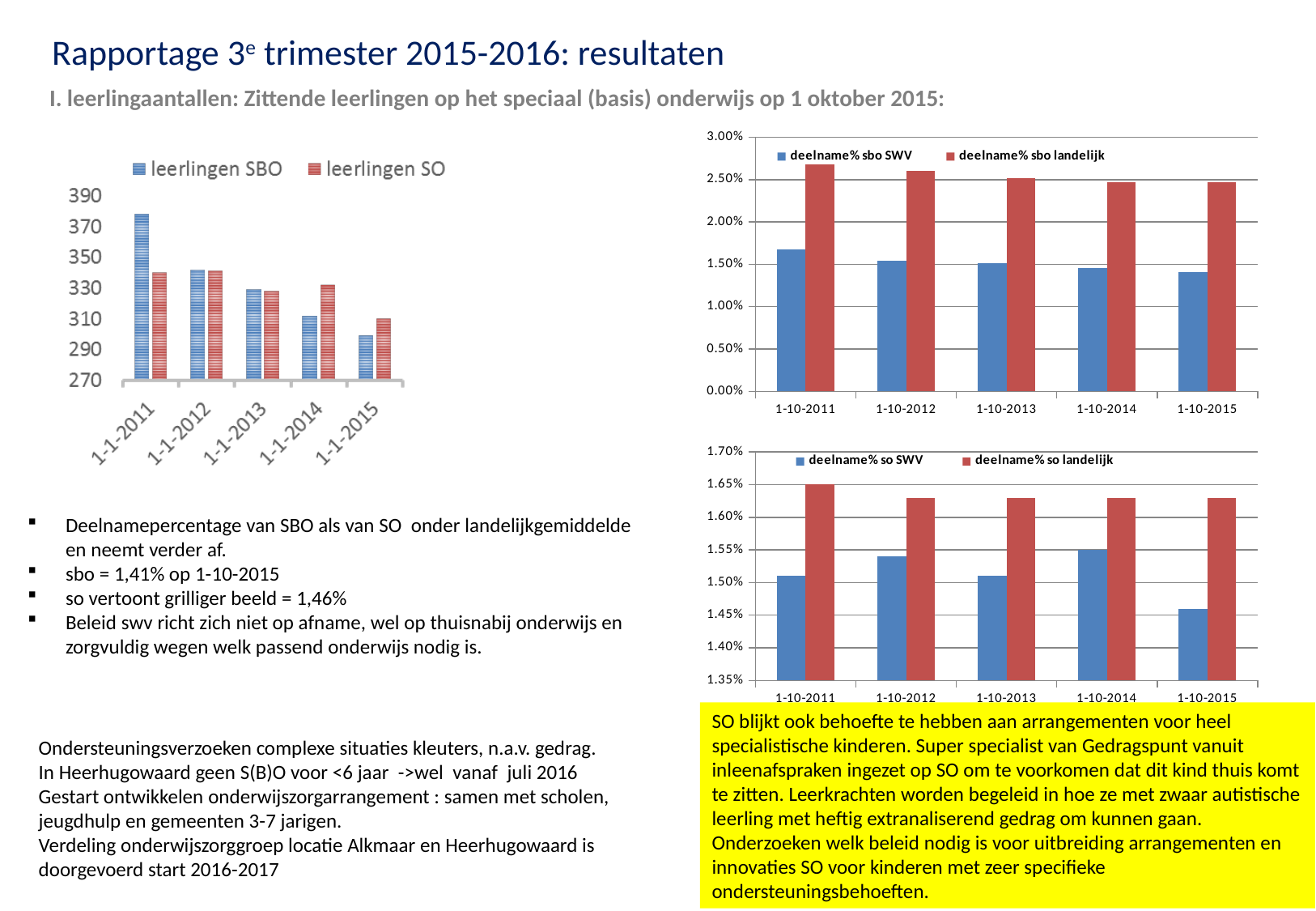
In the chart at the top left (leerlingen SBO / leerlingen SO), is the value for leerlingen SBO on 1-1-2011 greater or less than 370? greater In the top right chart (deelname% sbo SWV / deelname% sbo landelijk), which is larger on 1-10-2011: deelname% sbo SWV or deelname% sbo landelijk? deelname% sbo landelijk In the chart at the top left (leerlingen SBO / leerlingen SO), how many dates are shown on the x axis? 5 In the chart at the top left (leerlingen SBO / leerlingen SO), do the values for leerlingen SBO rise or fall from 1-1-2011 to 1-1-2015? fall In the top right chart (deelname% sbo SWV / deelname% sbo landelijk), is the value for deelname% sbo SWV on 1-10-2015 greater or less than 1.50%? less In the bottom right chart (deelname% so SWV / deelname% so landelijk), on which date is the value for deelname% so SWV lowest? 1-10-2015 In the chart at the top left (leerlingen SBO / leerlingen SO), which is larger on 1-1-2011: leerlingen SBO or leerlingen SO? leerlingen SBO In the chart at the top left (leerlingen SBO / leerlingen SO), on which date is the value for leerlingen SBO highest? 1-1-2011 In the chart at the top left with legend 'leerlingen SBO' and 'leerlingen SO', how many series does the legend list? 2 What kind of chart is the top right chart with legend 'deelname% sbo SWV' and 'deelname% sbo landelijk'? bar chart In the bottom right chart (deelname% so SWV / deelname% so landelijk), is the value for deelname% so landelijk on 1-10-2011 greater or less than 1.60%? greater In the chart at the top left (leerlingen SBO / leerlingen SO), on which date is the value for leerlingen SBO lowest? 1-1-2015